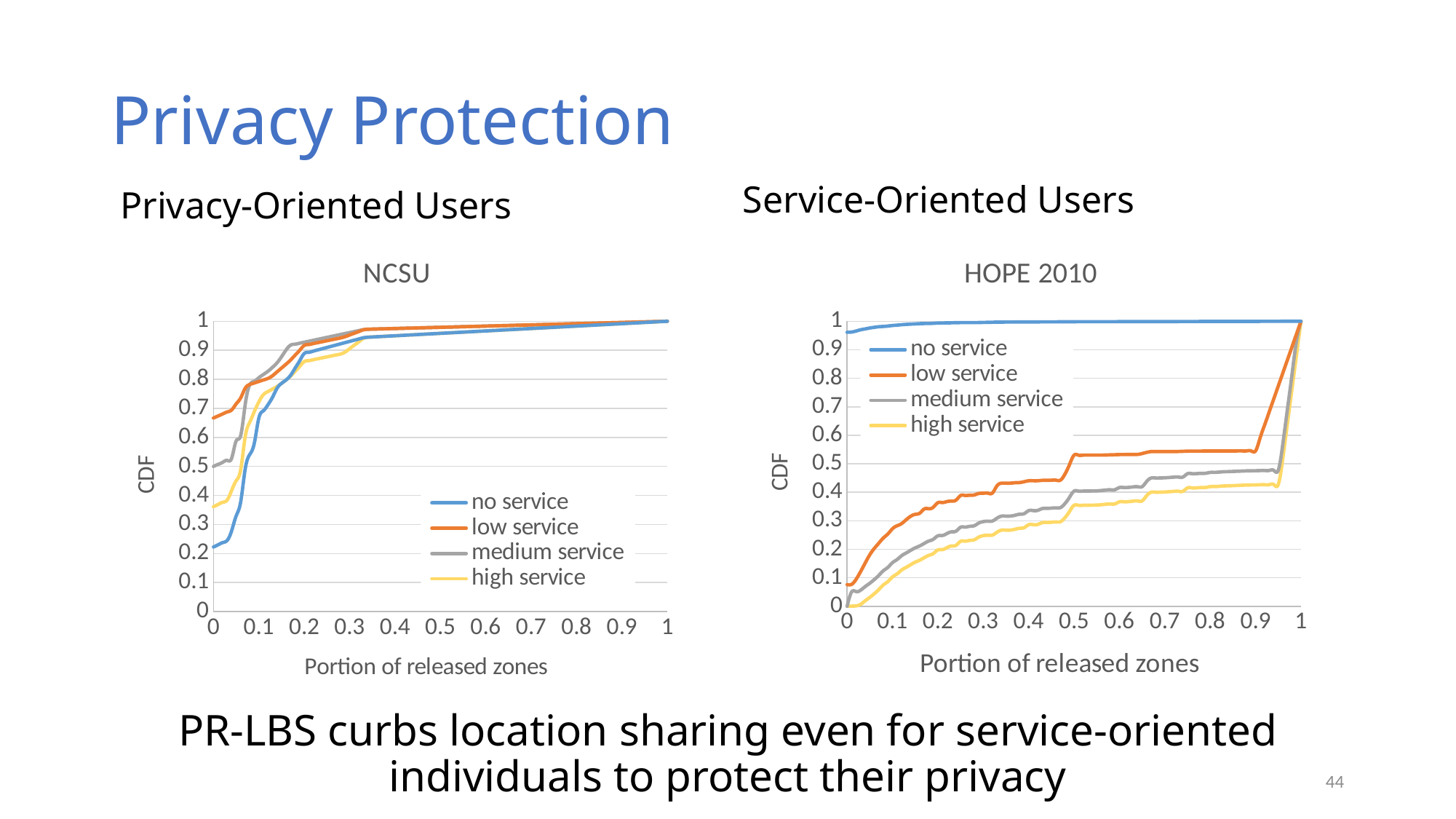
In the HOPE 2010 chart, at x = 0.5, which line is higher: low service or high service? low service In the HOPE 2010 chart, is the value of the no service line at x = 0 greater or less than 0.9? greater In the NCSU chart, at x = 0, which line is higher: low service or no service? low service In the NCSU chart, do the lines rise or fall as the portion of released zones increases? rise What kind of chart is the NCSU chart? line chart In the HOPE 2010 chart, is the value of the high service line at x = 0.9 greater or less than 0.5? less In the NCSU chart, is the value of the no service line at x = 0 greater or less than 0.3? less What is the x-axis label of the HOPE 2010 chart? Portion of released zones How many series does the legend of the HOPE 2010 chart list? 4 What is the title of the chart on the left of the slide? NCSU